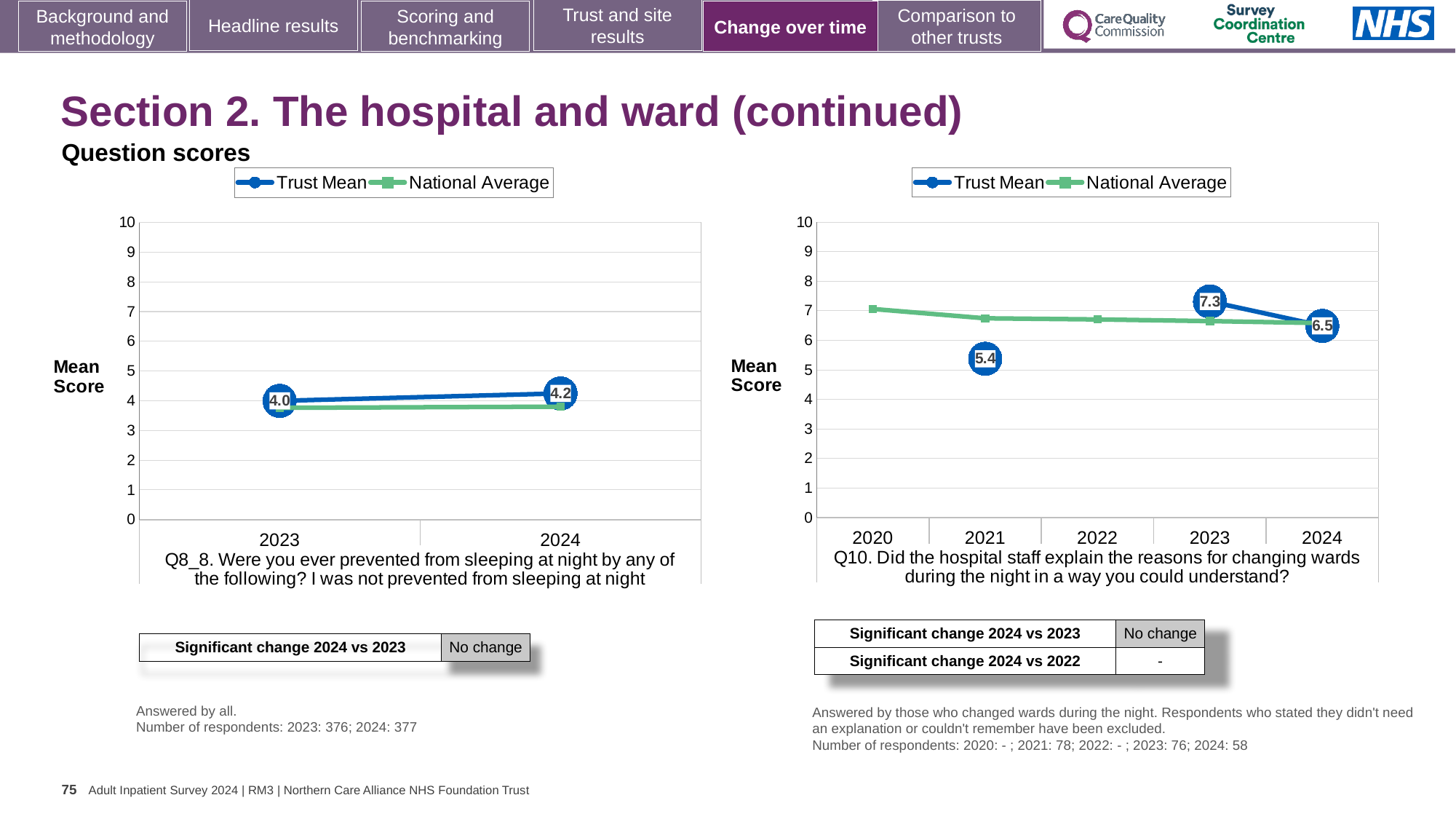
In the left chart (Q8_8), by how much did the Trust Mean change from 2023 to 2024? 0.2 In the right chart (Q10), what is the difference between the Trust Mean in 2023 and 2024? 0.8 In the right chart (Q10), what is the Trust Mean score for 2023? 7.3 In the right chart (Q10), which year has the lowest Trust Mean score? 2021 In the left chart (Q8_8), what is the Trust Mean score for 2024? 4.2 What type of chart is the left chart (Q8_8)? line chart In the right chart (Q10), what is the Trust Mean score for 2021? 5.4 In the right chart (Q10), is the National Average for 2020 greater or less than 6? greater How many years are shown on the x axis of the right chart (Q10)? 5 In the left chart (Q8_8), what is the Trust Mean score for 2023? 4.0 In the right chart (Q10), which year has the highest Trust Mean score? 2023 In the left chart (Q8_8), does the Trust Mean rise or fall from 2023 to 2024? rise